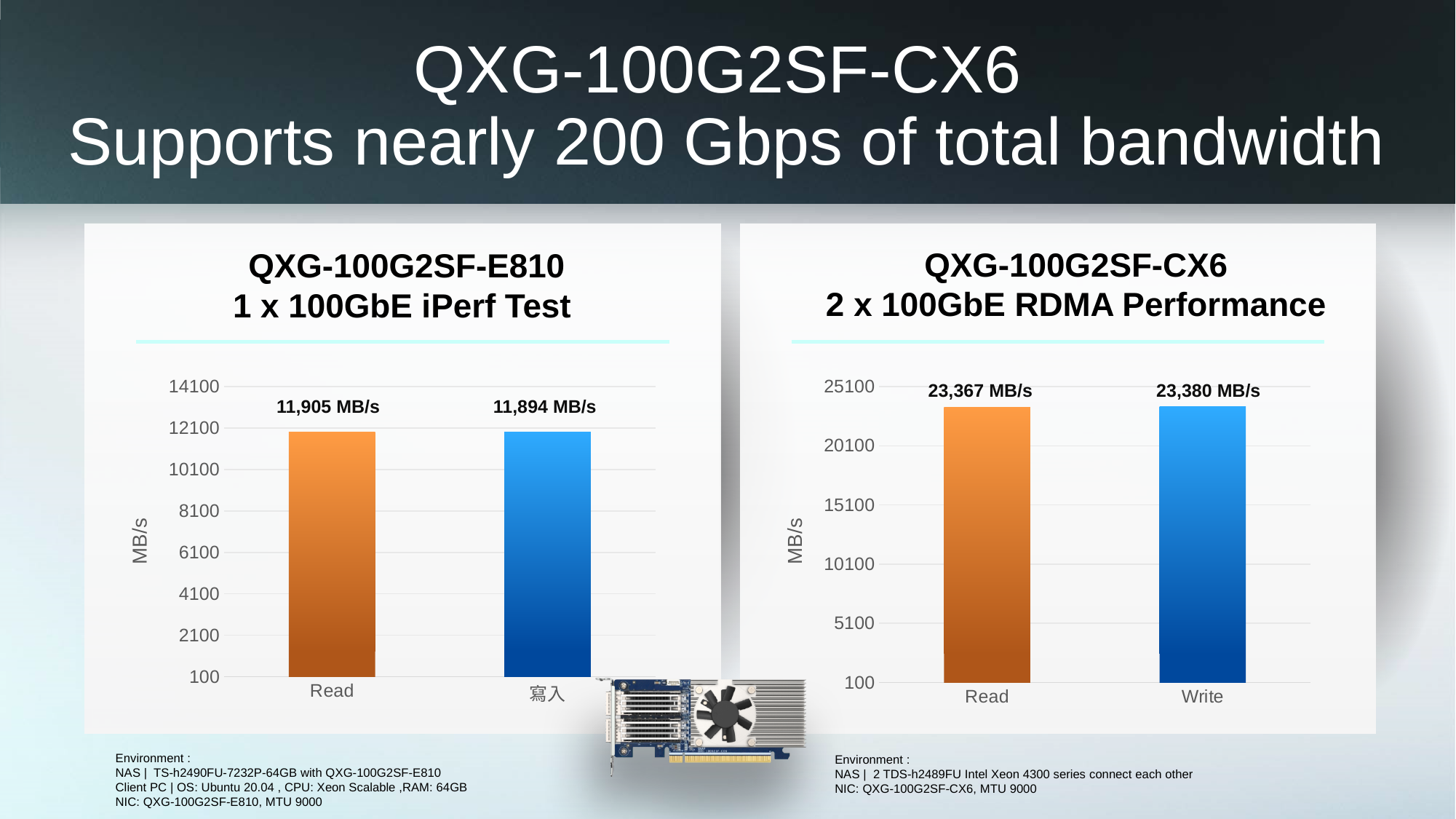
What kind of chart is the QXG-100G2SF-CX6 2 x 100GbE RDMA Performance chart? bar chart How many categories are shown in the QXG-100G2SF-CX6 2 x 100GbE RDMA Performance chart? 2 In the QXG-100G2SF-E810 1 x 100GbE iPerf Test chart, what is the value for 寫入? 11,894 MB/s In the QXG-100G2SF-E810 1 x 100GbE iPerf Test chart, what is the difference between the Read and 寫入 values? 11 MB/s In the QXG-100G2SF-CX6 2 x 100GbE RDMA Performance chart, what is the difference between the Write and Read values? 13 MB/s In the QXG-100G2SF-CX6 2 x 100GbE RDMA Performance chart, is the value for Write greater or less than 25100? less In the QXG-100G2SF-E810 1 x 100GbE iPerf Test chart, is the value for Read greater or less than 10100? greater How many bars are shown in the QXG-100G2SF-E810 1 x 100GbE iPerf Test chart? 2 What is the y-axis label of the QXG-100G2SF-E810 1 x 100GbE iPerf Test chart? MB/s In the QXG-100G2SF-CX6 2 x 100GbE RDMA Performance chart, what is the value for Write? 23,380 MB/s In the QXG-100G2SF-E810 1 x 100GbE iPerf Test chart, what is the value for Read? 11,905 MB/s In the QXG-100G2SF-CX6 2 x 100GbE RDMA Performance chart, what is the value for Read? 23,367 MB/s